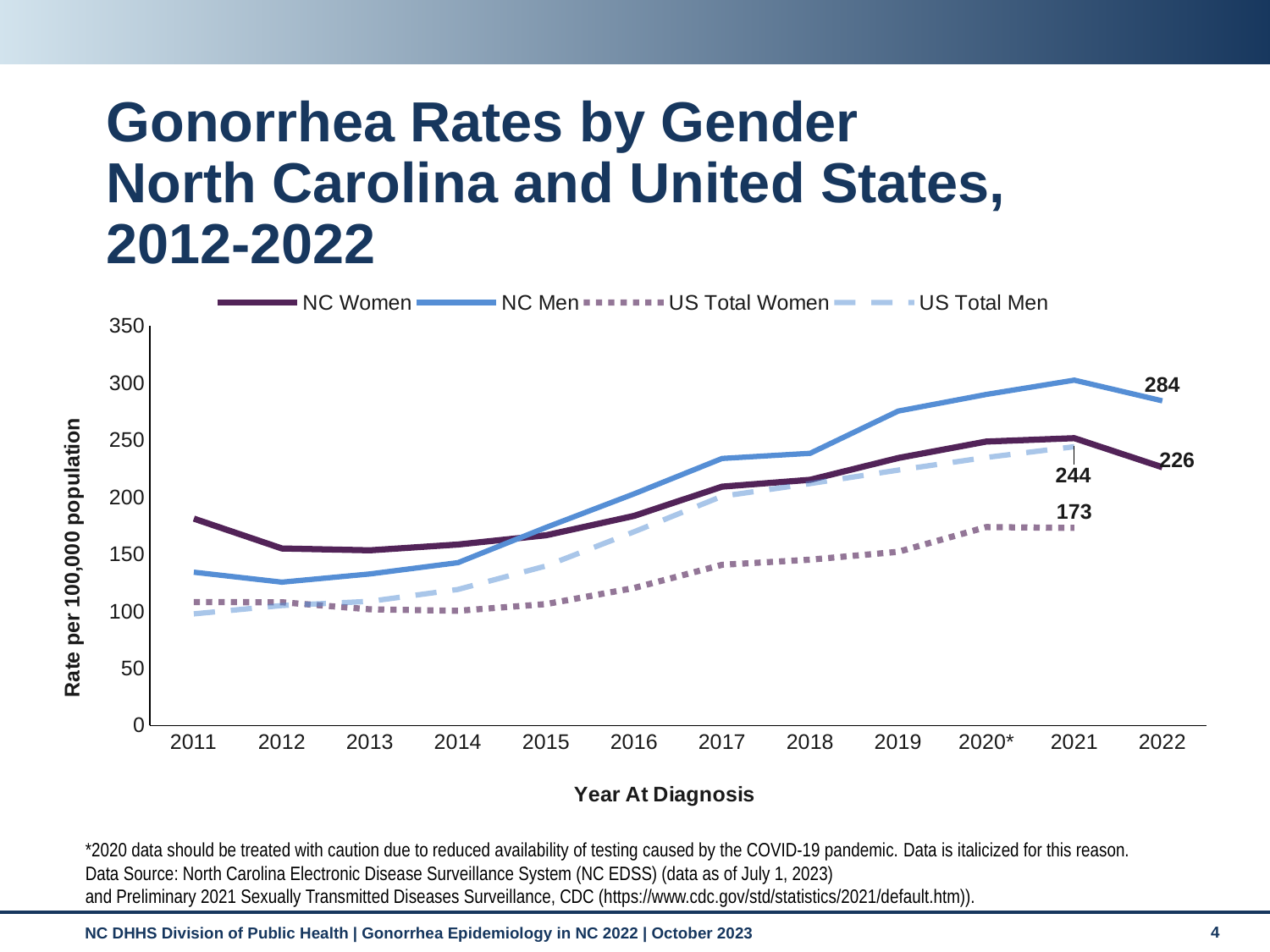
What is the difference between the NC Men and NC Women rates in 2022? 58 How many series does the legend list? 4 What is the value labeled for US Total Women in 2021? 173 Is the value for US Total Women in 2014 greater or less than 150? less What is the gonorrhea rate for NC Men in 2022? 284 What is the gonorrhea rate for NC Women in 2022? 226 In 2022, which is higher: the NC Men rate or the NC Women rate? NC Men What kind of chart is shown on the slide? Line chart What is the value labeled for US Total Men in 2021? 244 How many years are shown on the x axis? 12 Is the value for NC Women in 2011 greater or less than 150? greater What is the difference between the US Total Men and US Total Women values in 2021? 71